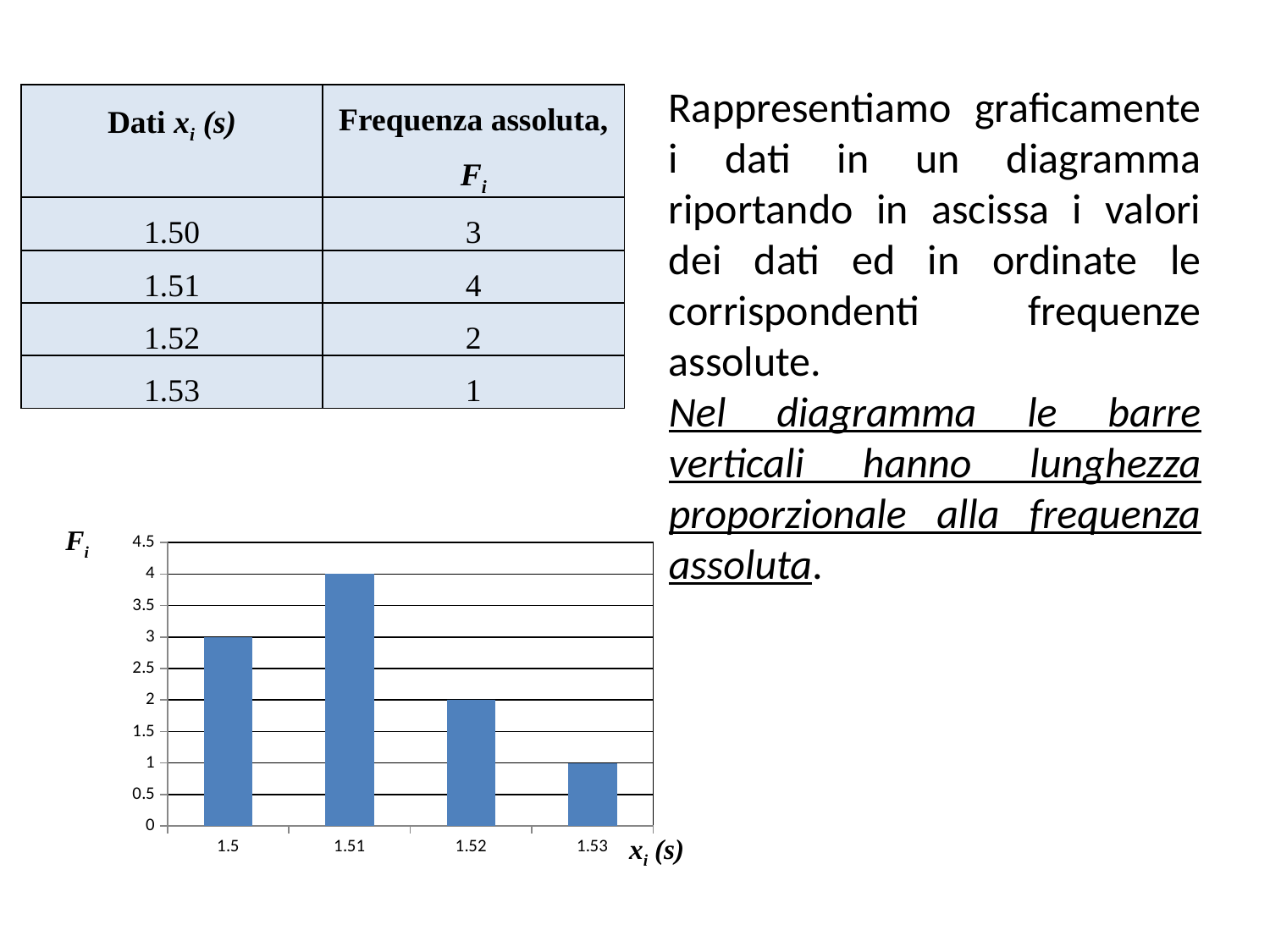
Which is larger, the value for 1.5 or the value for 1.52? 1.5 What is the highest tick value shown on the vertical axis? 4.5 What is the value of the bar for x = 1.51? 4 What kind of chart is shown on the slide? bar chart What is the difference between the values for 1.51 and 1.52? 2 Is the value for 1.51 greater or less than 3.5? greater Which category has the highest bar? 1.51 What is the value of the bar for x = 1.53? 1 Which category has the lowest bar? 1.53 What is the value of the bar for x = 1.5? 3 What is the label on the vertical axis of the chart? F_i How many bars (categories) does the chart show? 4